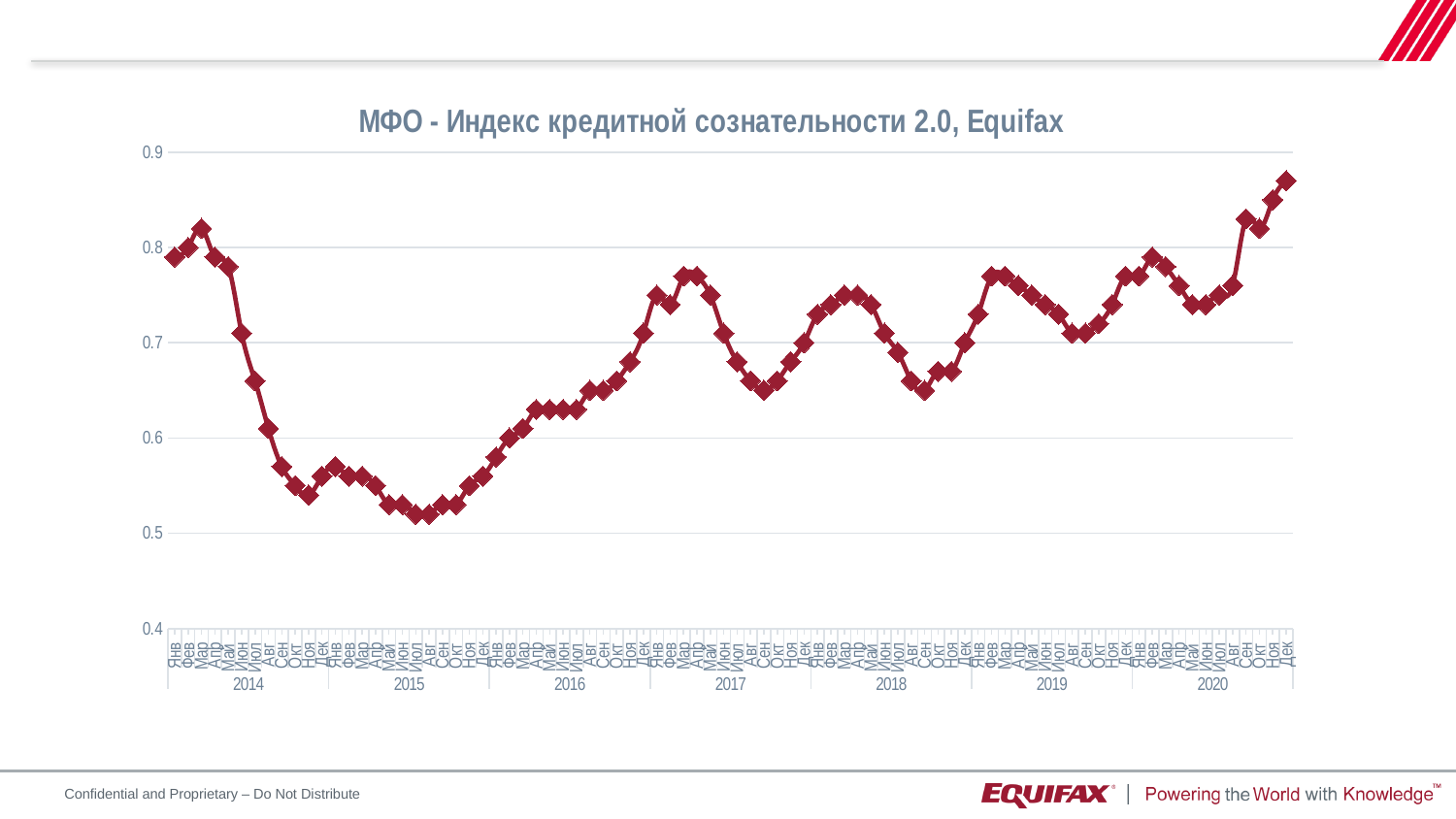
Does the line rise or fall overall from Янв 2020 to Дек 2020? rise In which year does the line reach its highest point? 2020 Is the value for Сен 2017 greater or less than 0.7? less What is the title of the chart? МФО - Индекс кредитной сознательности 2.0, Equifax Is the value for Окт 2018 greater or less than 0.7? less In which year does the line reach its lowest point? 2015 Is the value for Июн 2015 greater or less than 0.6? less How many years are labelled along the x axis of the chart? 7 Does the line rise or fall from Янв 2014 to Дек 2014? fall What kind of chart is shown on the slide? line chart